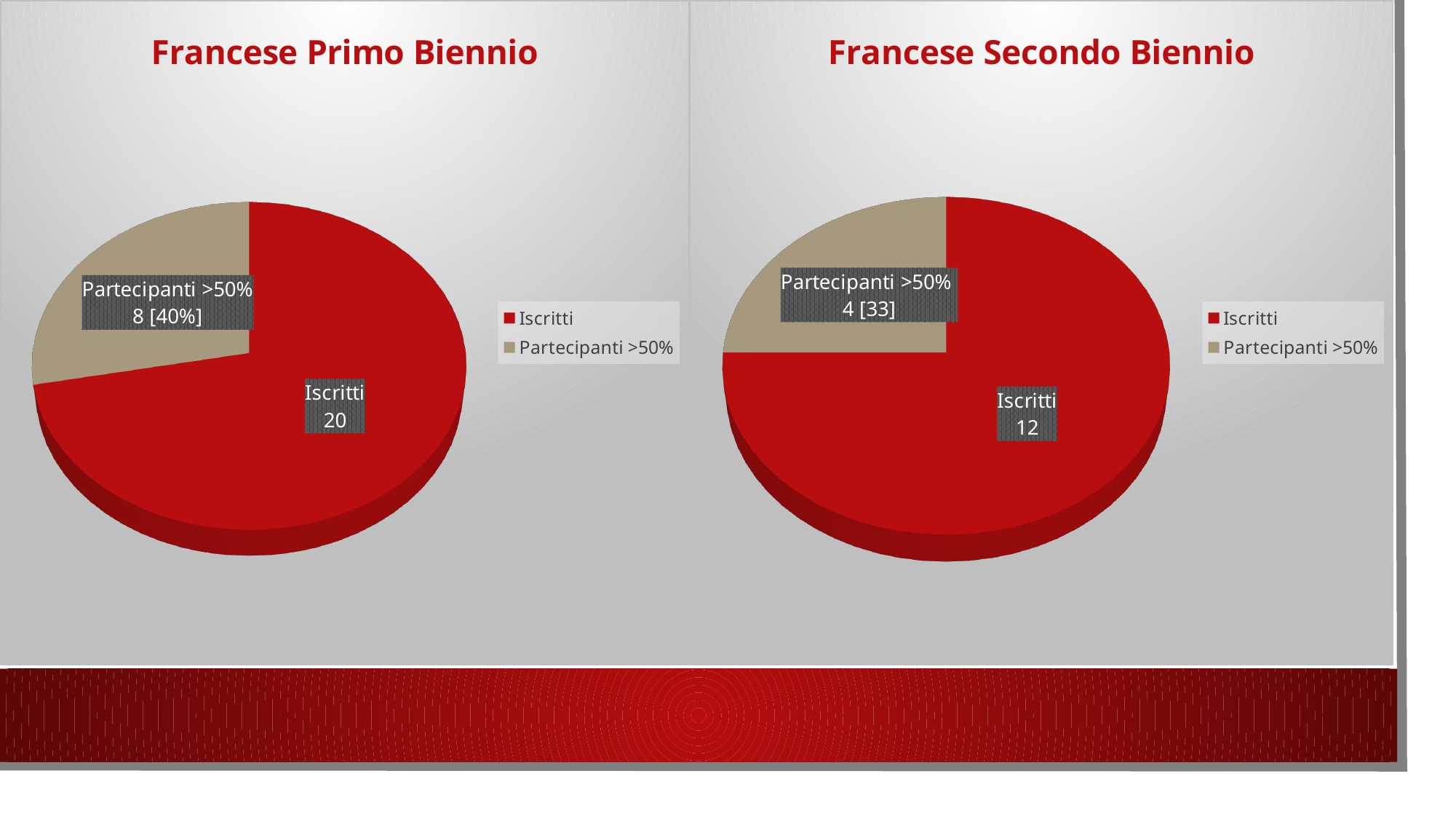
In the Francese Secondo Biennio chart, which category has the smallest slice? Partecipanti >50% In the Francese Primo Biennio chart, what is the data label shown for Partecipanti >50%? 8 [40%] In the Francese Secondo Biennio chart, what is the value for Iscritti? 12 In the Francese Secondo Biennio chart, what is the difference between Iscritti and Partecipanti >50%? 8 Which chart has the larger Iscritti value, Francese Primo Biennio or Francese Secondo Biennio? Francese Primo Biennio In the Francese Secondo Biennio chart, what colour is the Iscritti slice? Red In the Francese Secondo Biennio chart, what is the data label shown for Partecipanti >50%? 4 [33] In the Francese Primo Biennio chart, which category has the largest slice? Iscritti In the Francese Primo Biennio chart, what is the difference between Iscritti and Partecipanti >50%? 12 How many categories does the legend of the Francese Primo Biennio chart list? 2 What kind of chart is the Francese Secondo Biennio chart? Pie chart In the Francese Primo Biennio chart, what is the value for Iscritti? 20